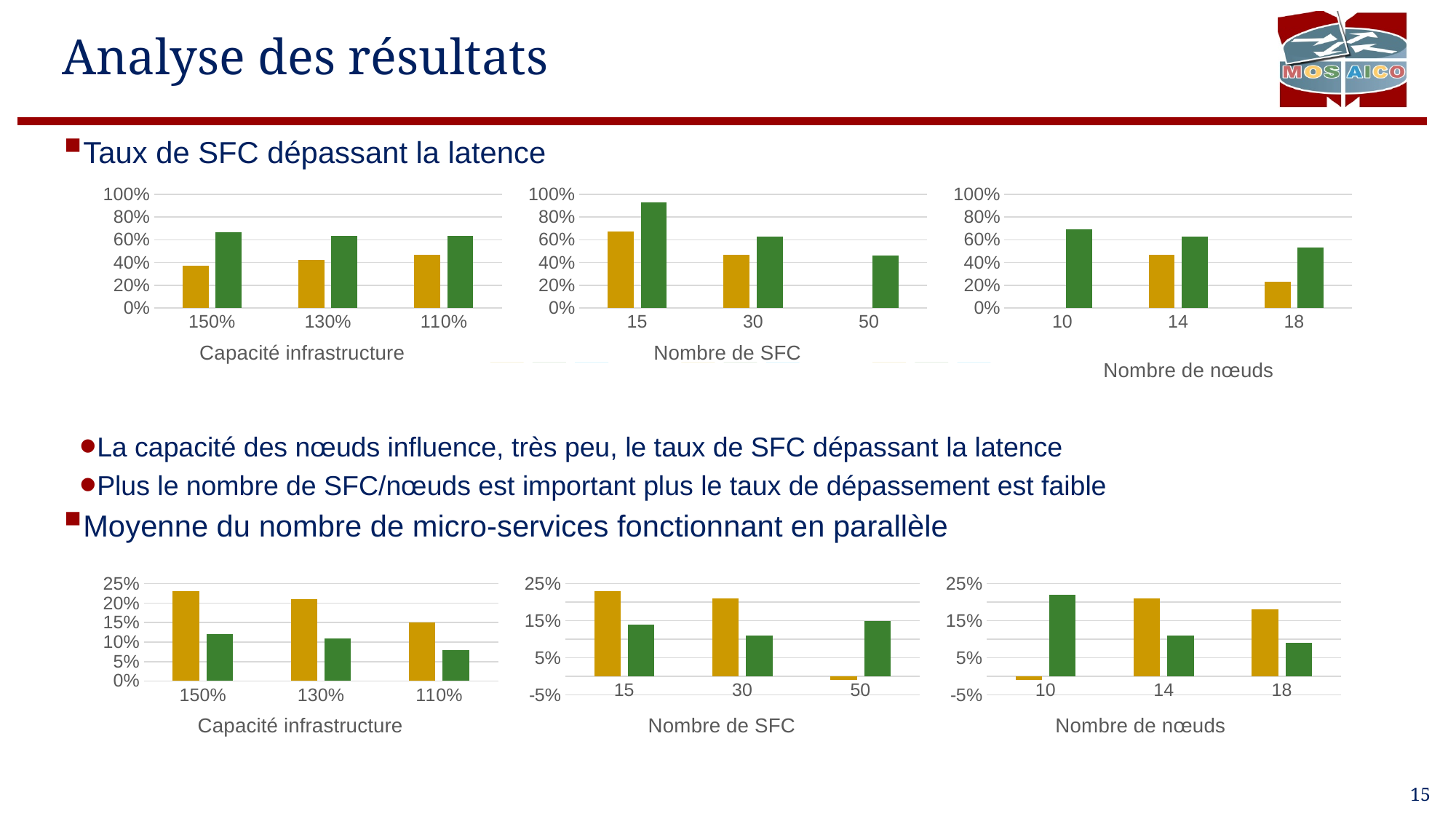
In the bottom-left chart (Capacité infrastructure, Moyenne du nombre de micro-services), do the yellow bars rise or fall from 150% to 110%? fall In the bottom-middle chart (Nombre de SFC, Moyenne du nombre de micro-services), which category has the taller green bar, 30 or 50? 50 In the top-right chart (Nombre de nœuds, Taux de SFC dépassant la latence), is the yellow bar for 18 greater or less than 40%? less In the bottom-left chart (Capacité infrastructure, Moyenne du nombre de micro-services), is the yellow bar for 150% greater or less than 20%? greater In the bottom-right chart (Nombre de nœuds, Moyenne du nombre de micro-services), is the green bar for 10 greater or less than 15%? greater What is the x-axis title of the top-right chart under 'Taux de SFC dépassant la latence'? Nombre de nœuds In the top-middle chart (Nombre de SFC, Taux de SFC dépassant la latence), which category has the taller yellow bar, 15 or 30? 15 In the top-left chart (Capacité infrastructure, Taux de SFC dépassant la latence), how many categories are shown on the x axis? 3 In the top-right chart (Nombre de nœuds, Taux de SFC dépassant la latence), which category has the tallest green bar? 10 What kind of chart is the top-left chart (Capacité infrastructure) under 'Taux de SFC dépassant la latence'? bar chart